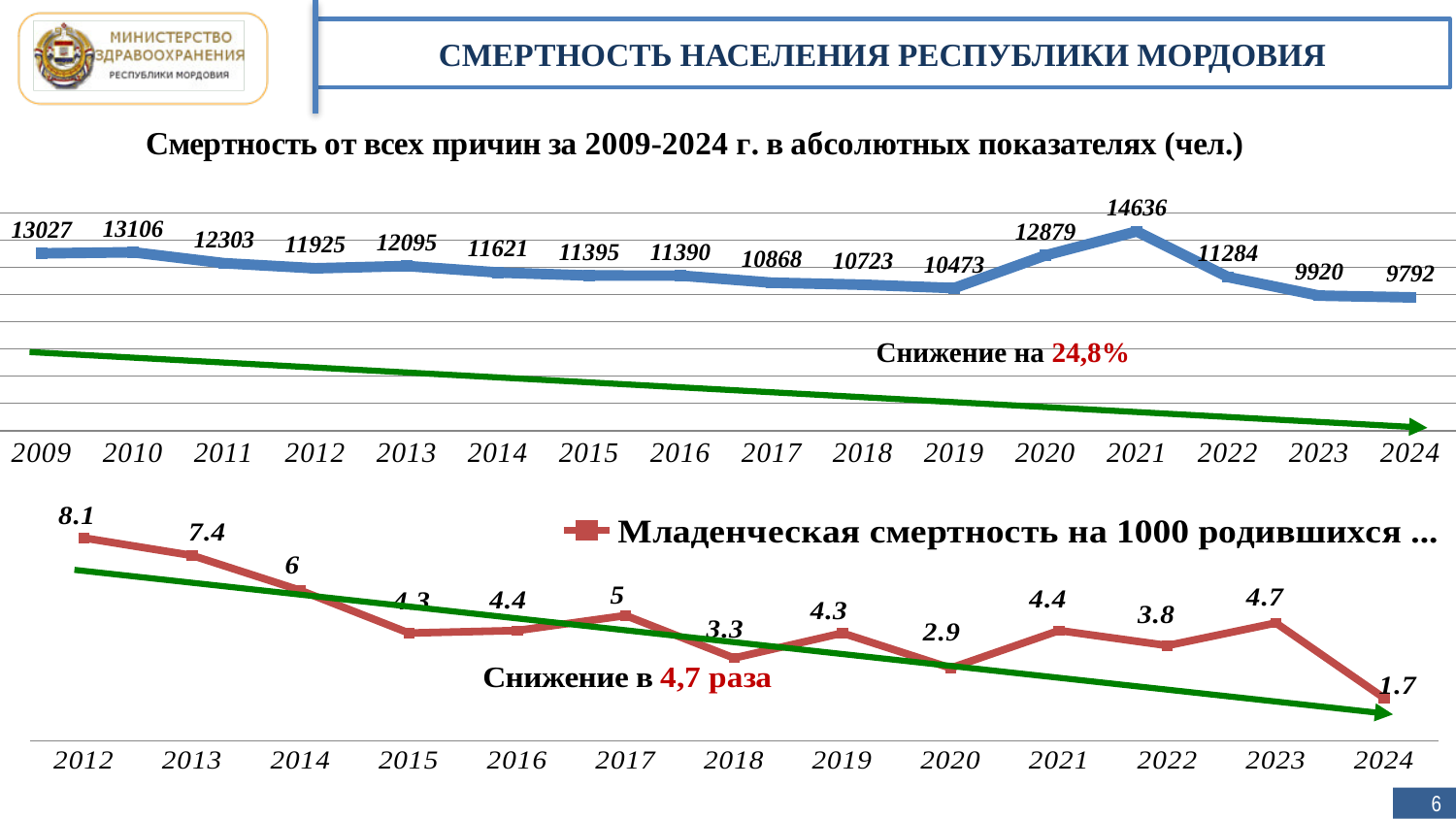
How many years are plotted on the top chart (mortality from all causes)? 16 On the bottom chart (infant mortality per 1000 births), what is the value for 2024? 1.7 How many years are plotted on the bottom chart (infant mortality per 1000 births)? 13 On the top chart (mortality from all causes), which is larger: the value for 2020 or the value for 2022? 2020 What type of chart is the top chart (mortality from all causes)? Line chart On the top chart (mortality from all causes), which year has the highest value? 2021 On the top chart (mortality from all causes, 2009-2024), what is the value for 2021? 14636 On the bottom chart (infant mortality per 1000 births), what is the difference between the 2023 value and the 2024 value? 3 On the top chart (mortality from all causes), what is the difference between the 2009 value and the 2024 value? 3235 On the bottom chart (infant mortality per 1000 births), which year has the highest value? 2012 On the top chart (mortality from all causes), which year has the lowest value? 2024 On the top chart (mortality from all causes), what is the value for 2024? 9792